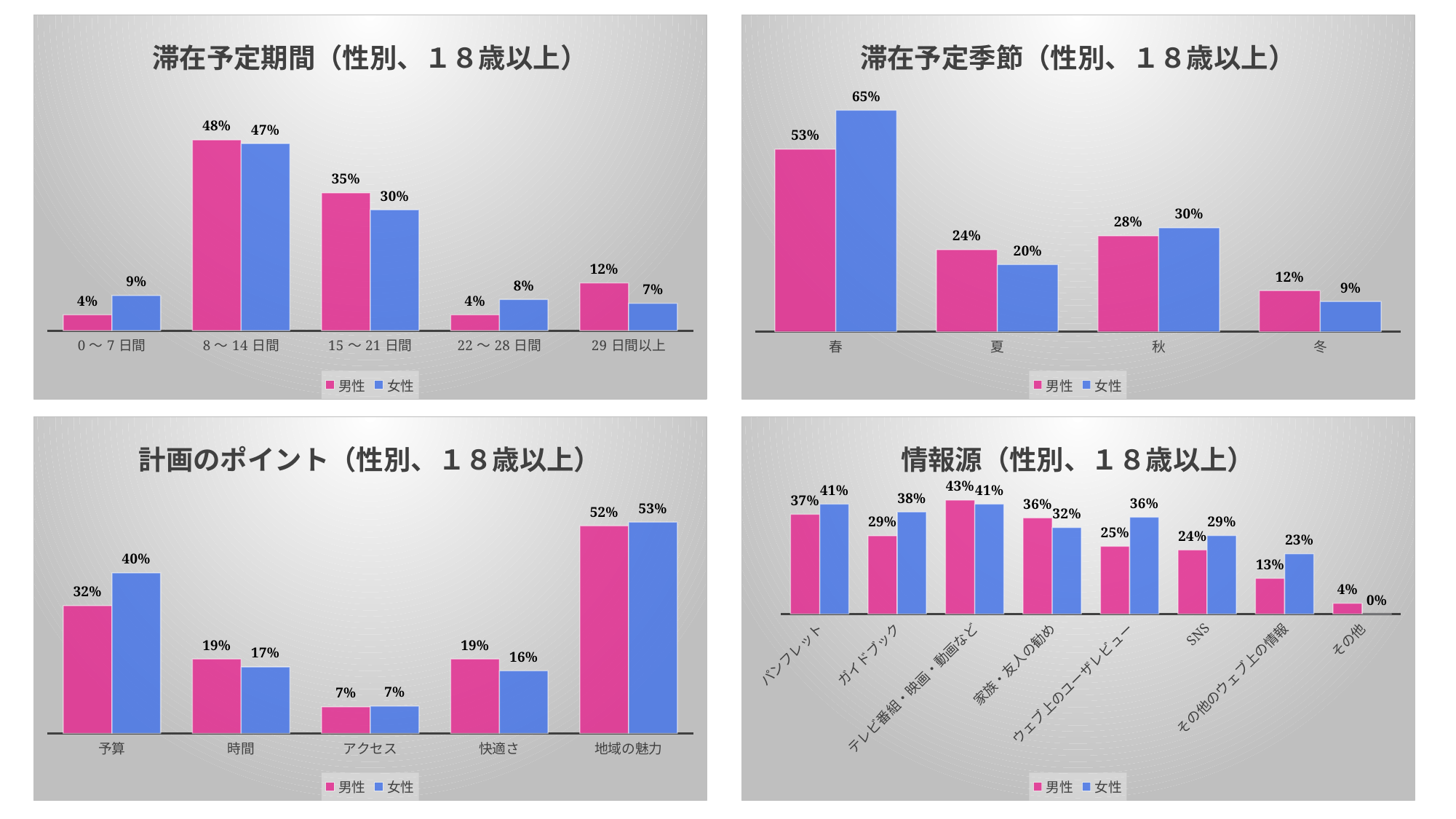
In the 滞在予定季節（性別、１８歳以上） chart, which is larger for 夏, the 男性 value or the 女性 value? 男性 In the 計画のポイント（性別、１８歳以上） chart, which category has the lowest 男性 value? アクセス In the 情報源（性別、１８歳以上） chart, what is the 男性 value for テレビ番組・映画・動画など? 43% In the 計画のポイント（性別、１８歳以上） chart, what is the 女性 value for 予算? 40% In the 計画のポイント（性別、１８歳以上） chart, what is the difference between the 女性 and 男性 values for 予算? 8% In the 滞在予定期間（性別、１８歳以上） chart, what is the difference between the 男性 and 女性 values for 15～21 日間? 5% In the 滞在予定期間（性別、１８歳以上） chart, what is the value for 女性 in the 8～14 日間 category? 47% In the 滞在予定季節（性別、１８歳以上） chart, what is the 男性 value for 秋? 28% How many series does the legend list in the 情報源（性別、１８歳以上） chart? 2 In the 滞在予定期間（性別、１８歳以上） chart, how many categories are shown on the x axis? 5 In the 滞在予定季節（性別、１８歳以上） chart, which season has the highest 女性 value? 春 In the 情報源（性別、１８歳以上） chart, how many categories are shown on the x axis? 8